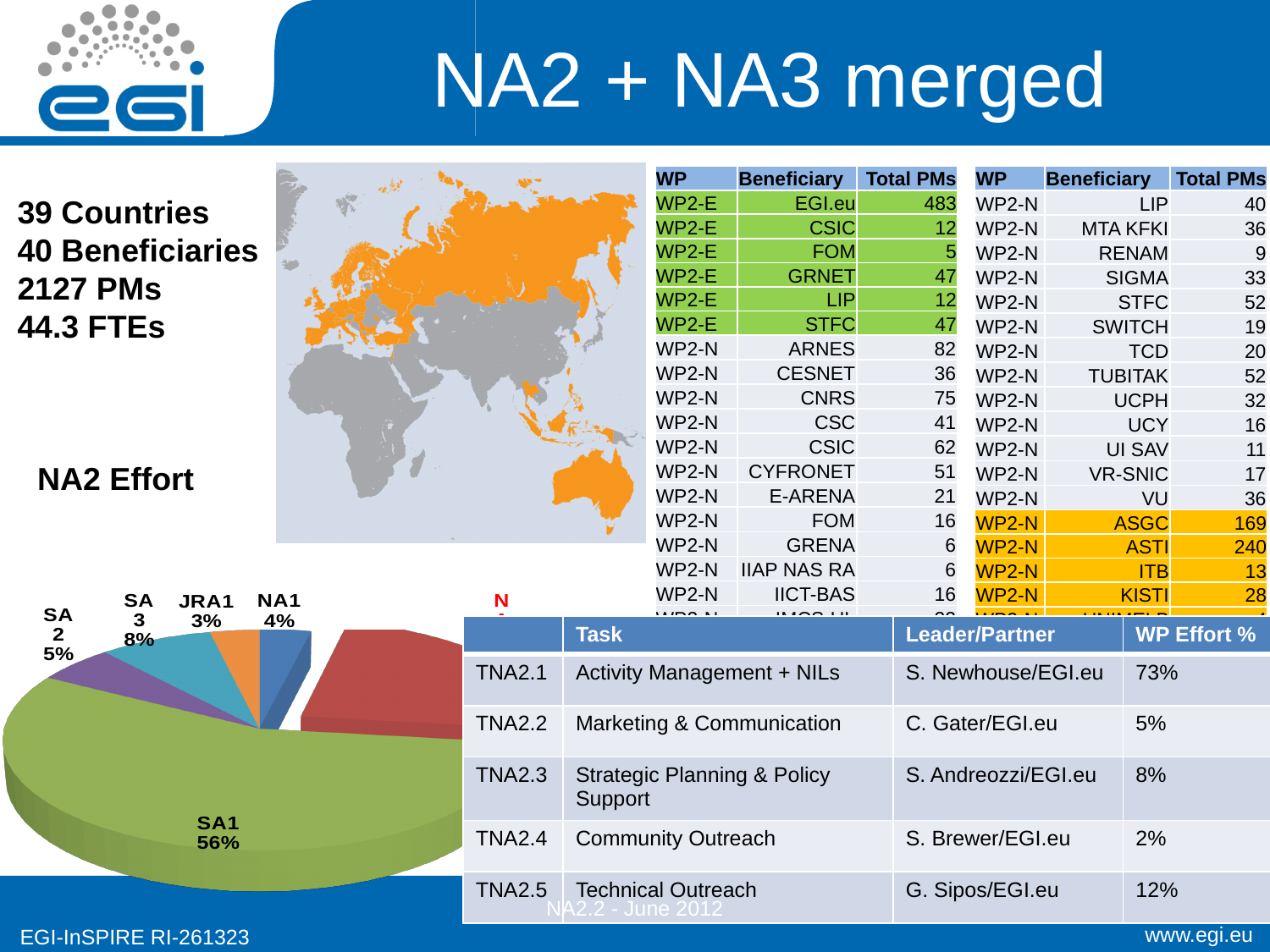
In the pie chart, which has the larger share, SA3 or NA1? SA3 In the pie chart, how many percentage points larger is SA1's share than SA3's share? 48% In the pie chart, how many percentage points larger is SA2's share than JRA1's share? 2% What colour is the SA1 slice in the pie chart? Green In the pie chart, what share is labelled for SA3? 8% In the pie chart, what share is labelled for SA1? 56% What kind of chart is shown at the bottom left of the slide? Pie chart In the pie chart, what share is labelled for SA2? 5% In the pie chart, what share is labelled for NA1? 4% In the pie chart, what share is labelled for JRA1? 3% Which labelled slice of the pie chart has the largest share? SA1 Which labelled slice of the pie chart has the smallest share? JRA1